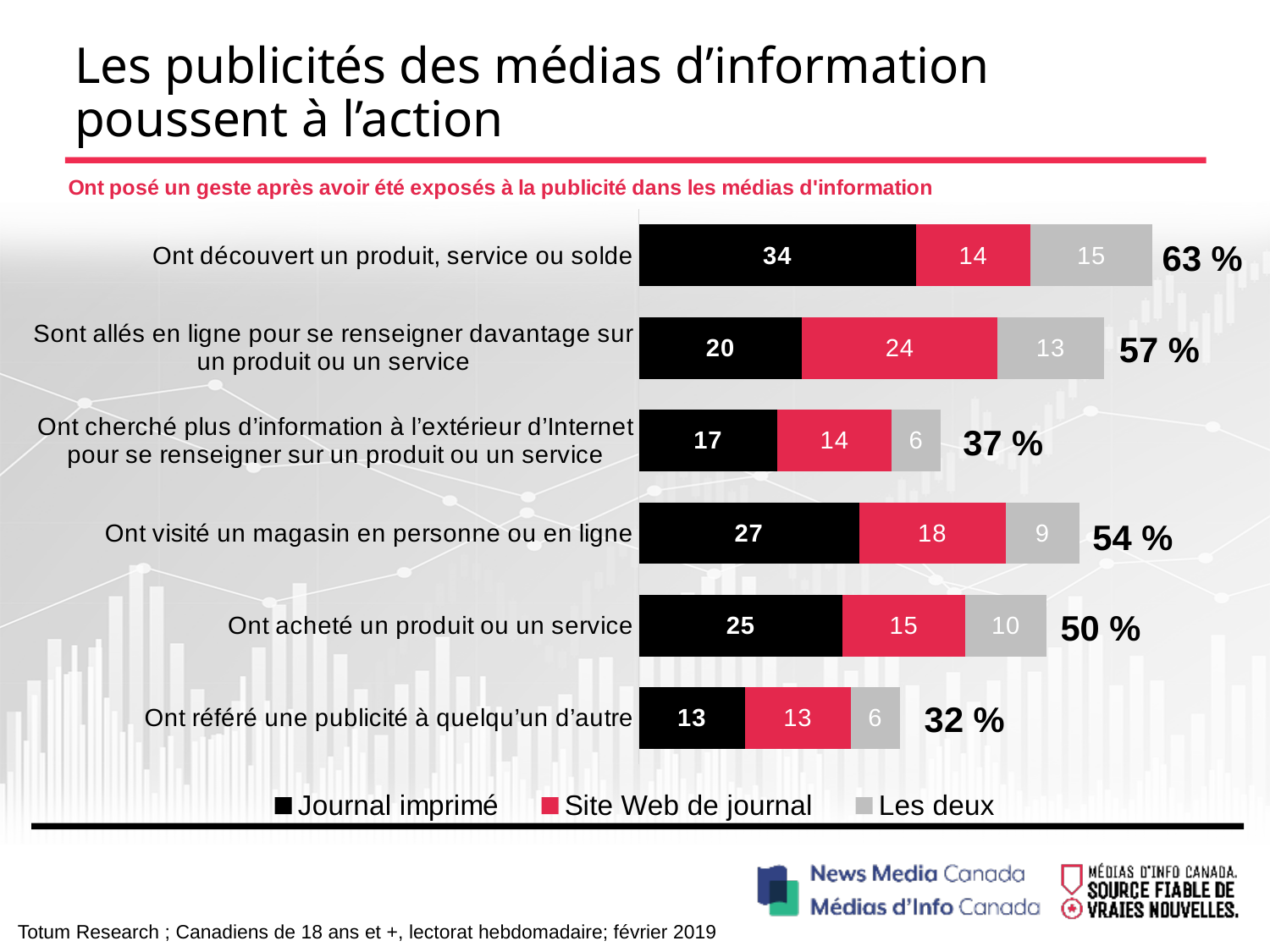
How many categories are plotted in the chart? 6 What is the total shown for the bar "Ont acheté un produit ou un service"? 50 % What is the value for "Les deux" in the category "Ont visité un magasin en personne ou en ligne"? 9 How many series does the legend list? 3 What is the value for "Journal imprimé" in the category "Ont découvert un produit, service ou solde"? 34 Which colour represents the series "Site Web de journal" in the chart? red Which category has the highest total? Ont découvert un produit, service ou solde In the category "Ont cherché plus d'information à l'extérieur d'Internet pour se renseigner sur un produit ou un service", which is larger: "Journal imprimé" or "Site Web de journal"? Journal imprimé What is the value for "Site Web de journal" in the category "Sont allés en ligne pour se renseigner davantage sur un produit ou un service"? 24 What is the difference between the "Journal imprimé" values for "Ont découvert un produit, service ou solde" and "Ont acheté un produit ou un service"? 9 What kind of chart is shown on the slide? stacked bar chart Which category has the lowest total? Ont référé une publicité à quelqu'un d'autre